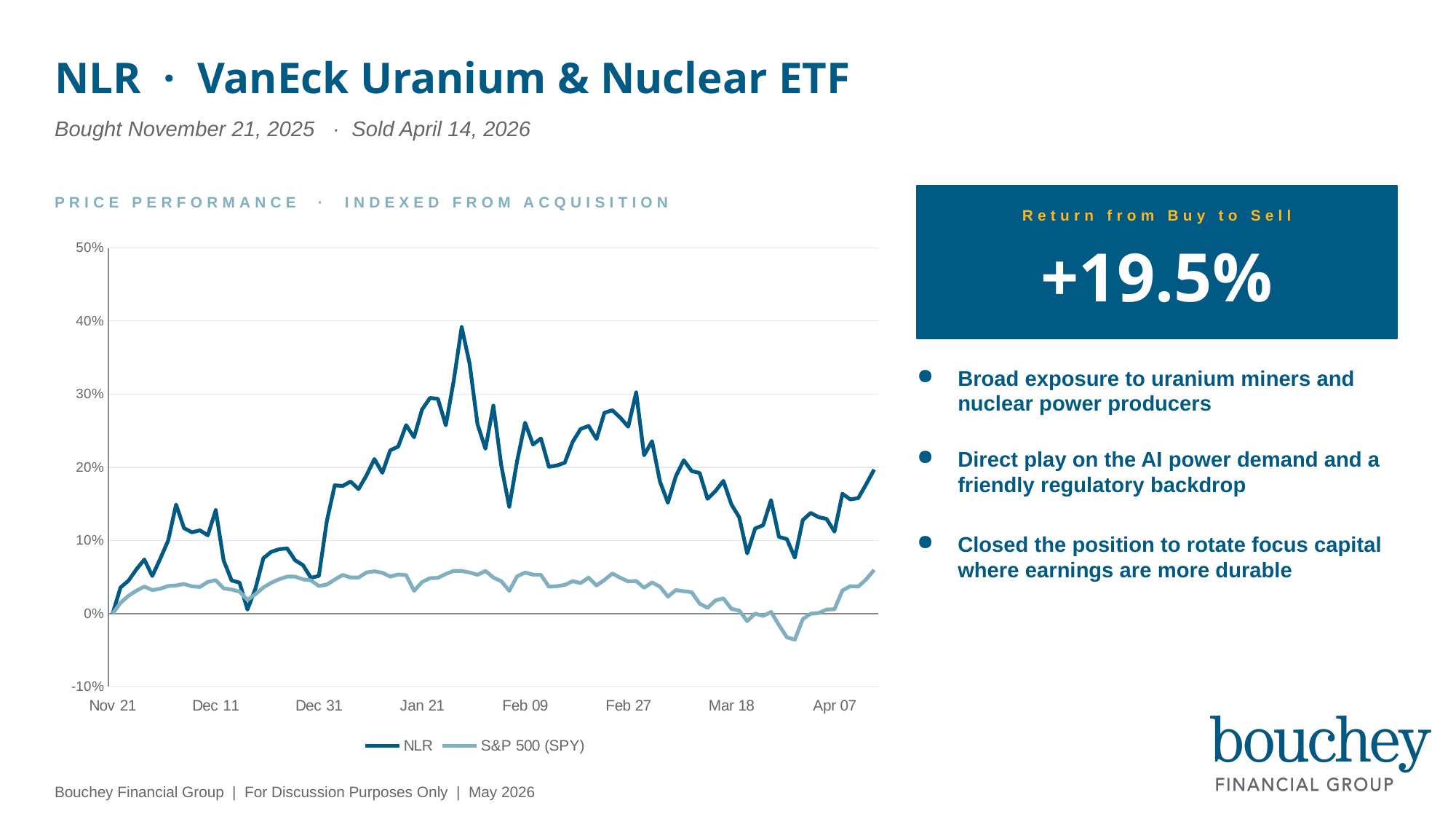
What is the title printed above the chart? PRICE PERFORMANCE · INDEXED FROM ACQUISITION What kind of chart is shown on the slide? line chart How many series does the chart legend list? 2 What are the two series named in the chart legend? NLR and S&P 500 (SPY) Is the lowest value reached by the S&P 500 (SPY) line greater or less than 0%? less Is the highest value reached by the S&P 500 (SPY) line greater or less than 10%? less Is the value of the NLR line at Jan 21 greater or less than 20%? greater Between Feb 27 and Mar 18, does the NLR line generally rise or fall? fall Between Nov 21 and Jan 21, does the NLR line generally rise or fall? rise At the right end of the chart, which series is higher, NLR or S&P 500 (SPY)? NLR